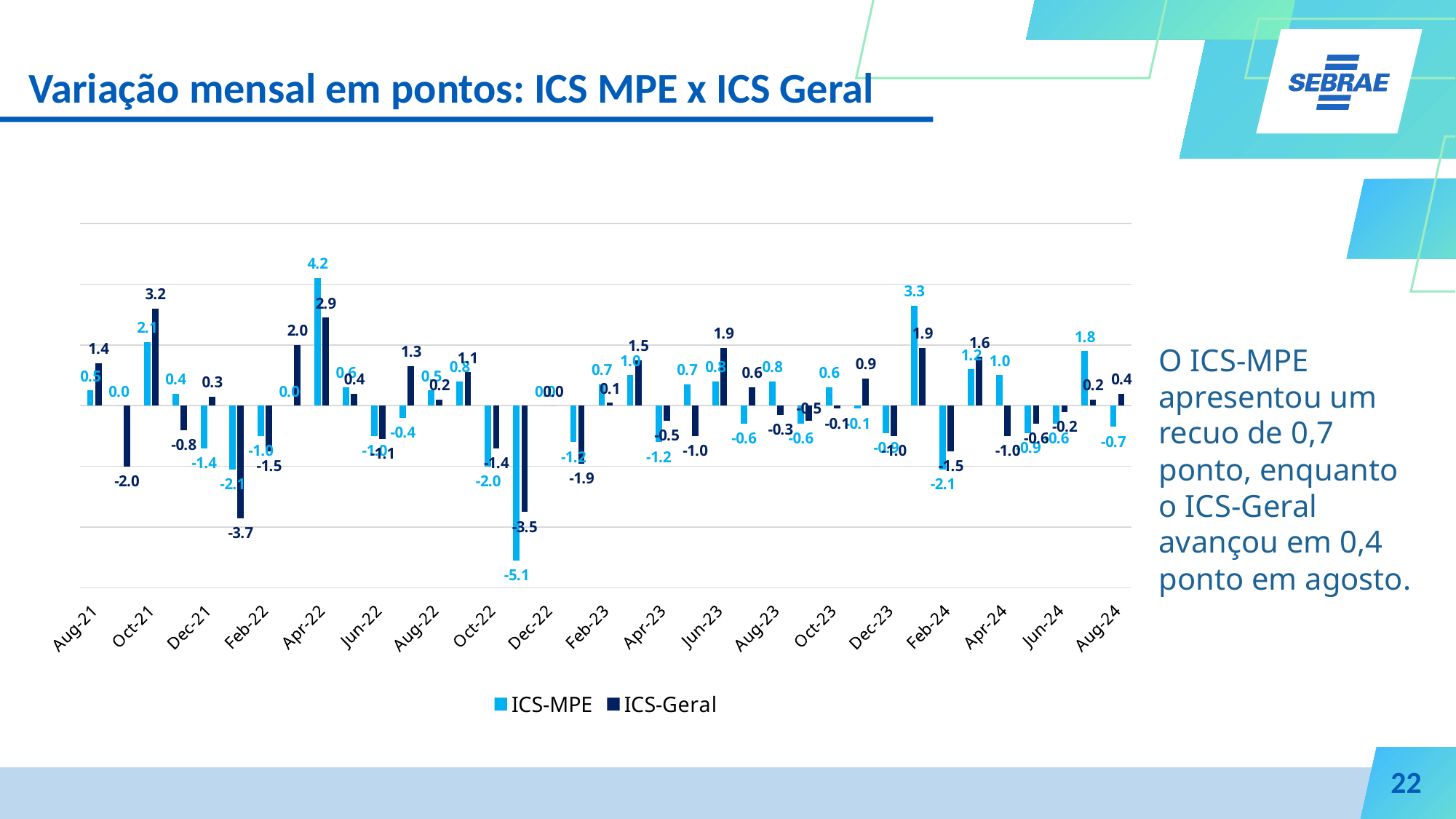
How many series does the chart legend list? 2 In Apr-22, which series has the larger value, ICS-MPE or ICS-Geral? ICS-MPE What is the ICS-Geral value for Aug-24? 0.4 What kind of chart is shown on the slide? Bar chart What is the difference between ICS-Geral and ICS-MPE in Oct-21? 1.1 What is the lowest ICS-MPE value shown on the chart? -5.1 What is the lowest ICS-Geral value shown on the chart? -3.7 In which month does ICS-Geral reach its highest value? Oct-21 In which month does ICS-MPE reach its highest value? Apr-22 What is the ICS-MPE value for Apr-22? 4.2 What is the ICS-Geral value for Jun-23? 1.9 What is the ICS-MPE value for Aug-24? -0.7